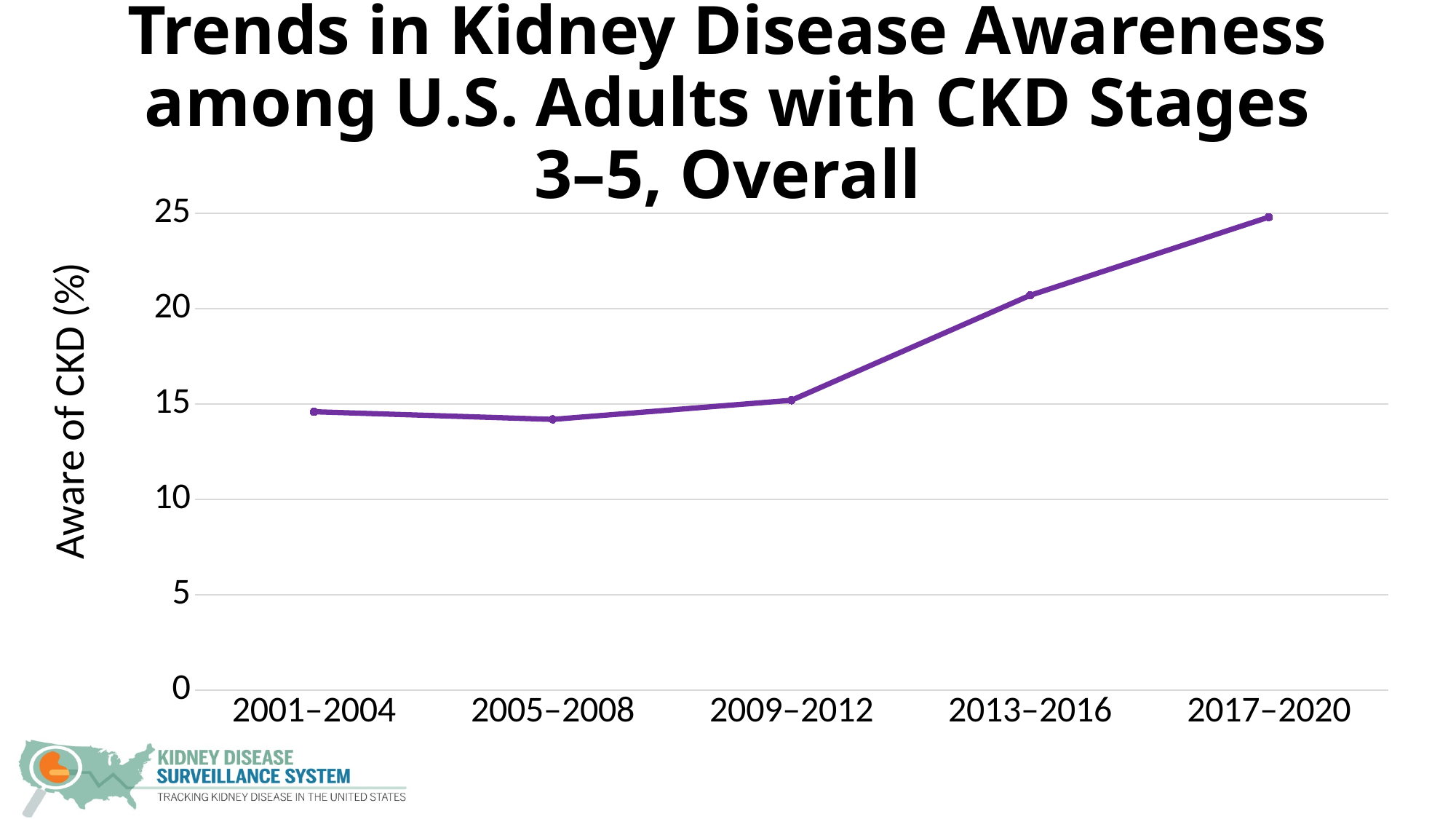
What is the label of the y axis? Aware of CKD (%) Is the value for 2005–2008 greater or less than 15? less Is the value for 2013–2016 greater or less than 25? less Do the values generally rise or fall from 2009–2012 to 2017–2020? rise Is the value for 2017–2020 greater or less than 20? greater How many time periods are plotted on the x axis? 5 Which is larger, the value for 2009–2012 or the value for 2013–2016? 2013–2016 Which is larger, the value for 2001–2004 or the value for 2017–2020? 2017–2020 Which period has the highest percentage aware of CKD? 2017–2020 What kind of chart is shown on the slide? line chart